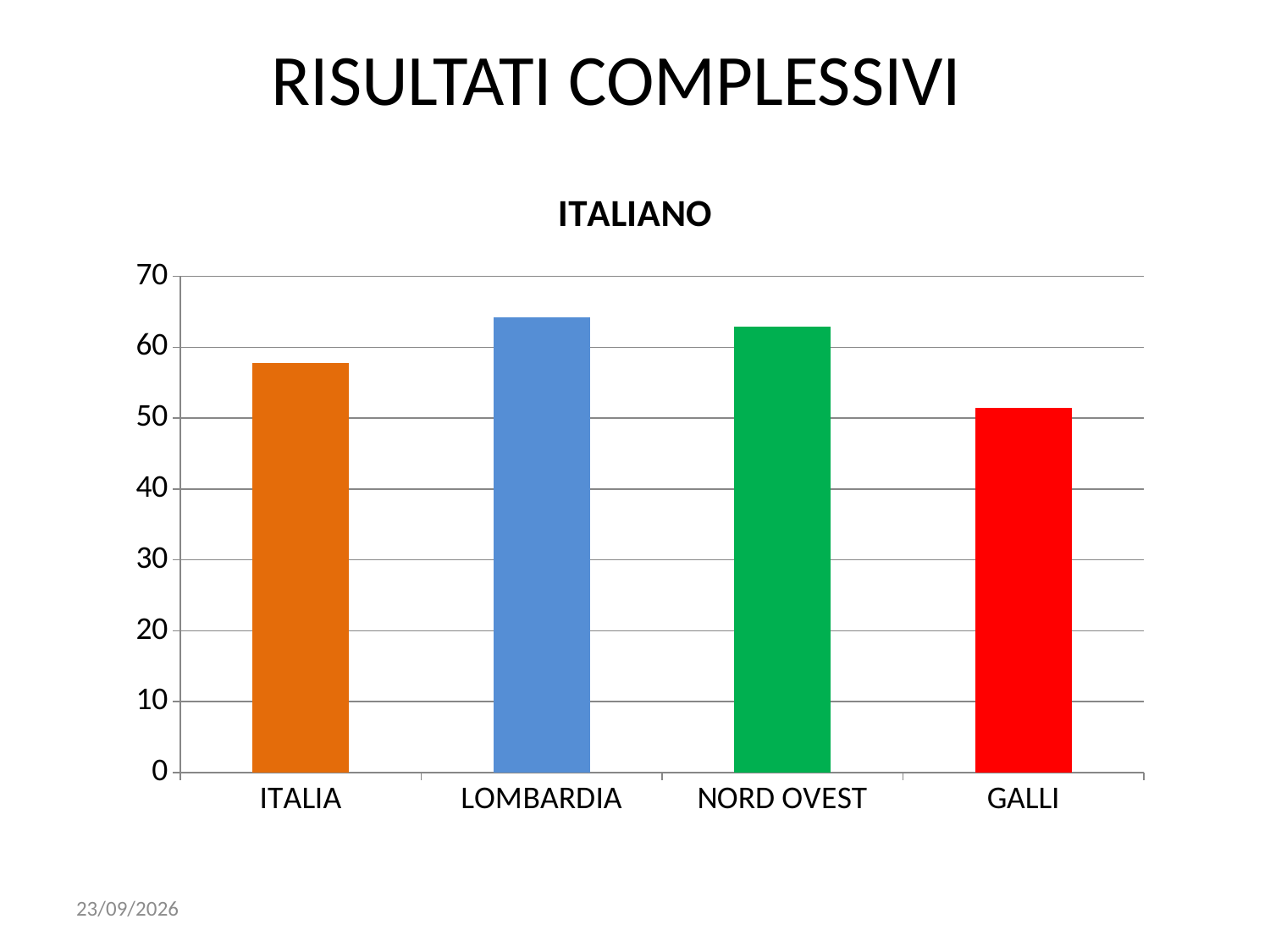
Which is larger, the value for ITALIA or the value for GALLI? ITALIA Which category has the highest bar in the chart? LOMBARDIA Is the value for NORD OVEST greater or less than 60? greater What is the title of the chart? ITALIANO Is the value for GALLI greater or less than 60? less Is the value for ITALIA greater or less than 50? greater What kind of chart is shown on the slide? bar chart How many categories are shown on the x axis of the chart? 4 What colour is the bar for GALLI? red Which category has the lowest bar in the chart? GALLI